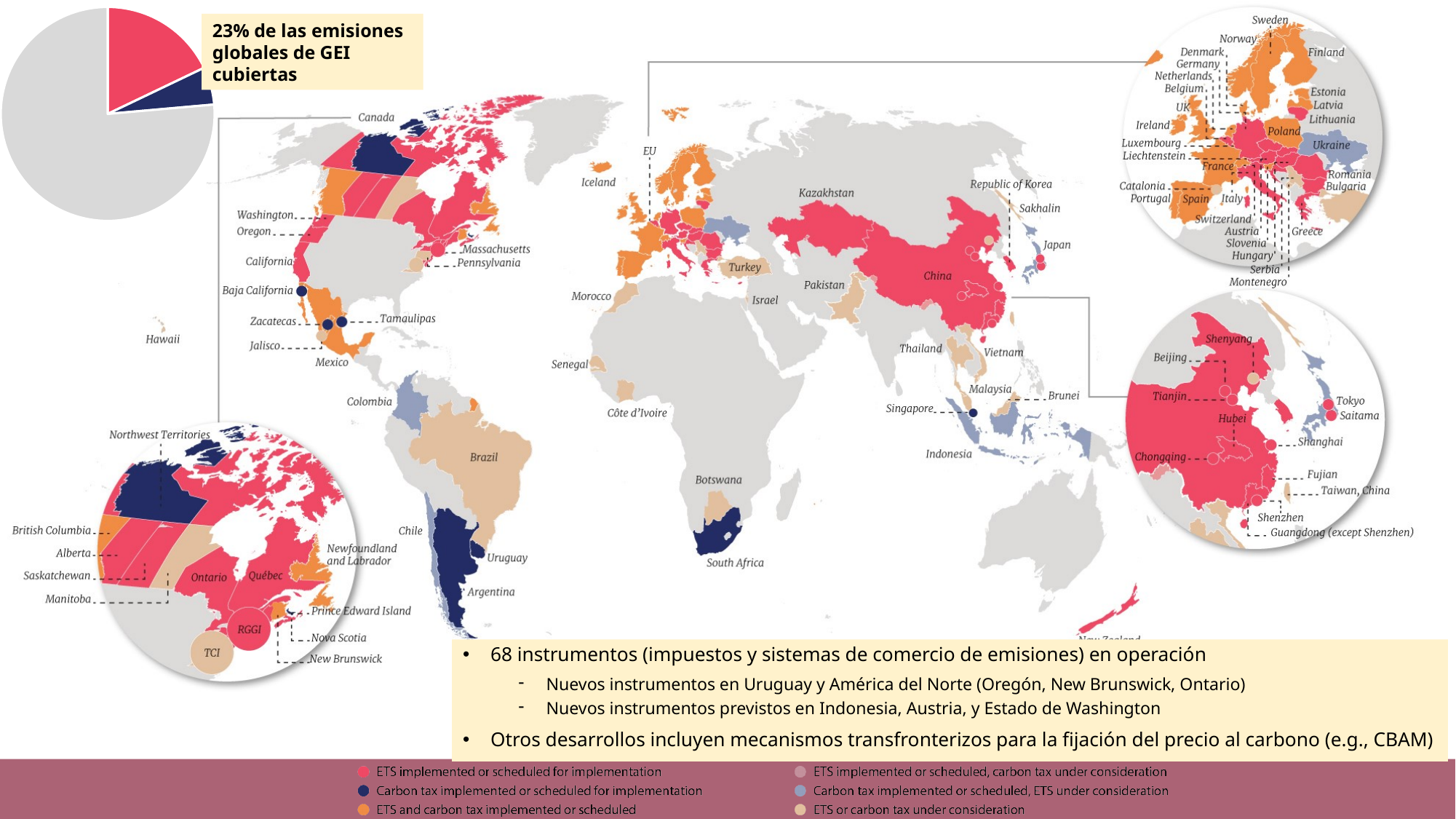
How many slices does the pie chart in the top-left corner have? 3 What colour is the largest slice of the pie chart? grey Which slice of the pie chart is the largest? the grey slice According to the map legend, what does the red colour represent? ETS implemented or scheduled for implementation Which slice of the pie chart is the smallest? the dark blue slice In the pie chart, which slice is larger, the red one or the dark blue one? the red one In the pie chart, which slice is larger, the grey one or the red one? the grey one According to the callout next to the pie chart, what percentage of global GHG emissions is covered? 23% What kind of chart is shown in the top-left corner of the slide? pie chart